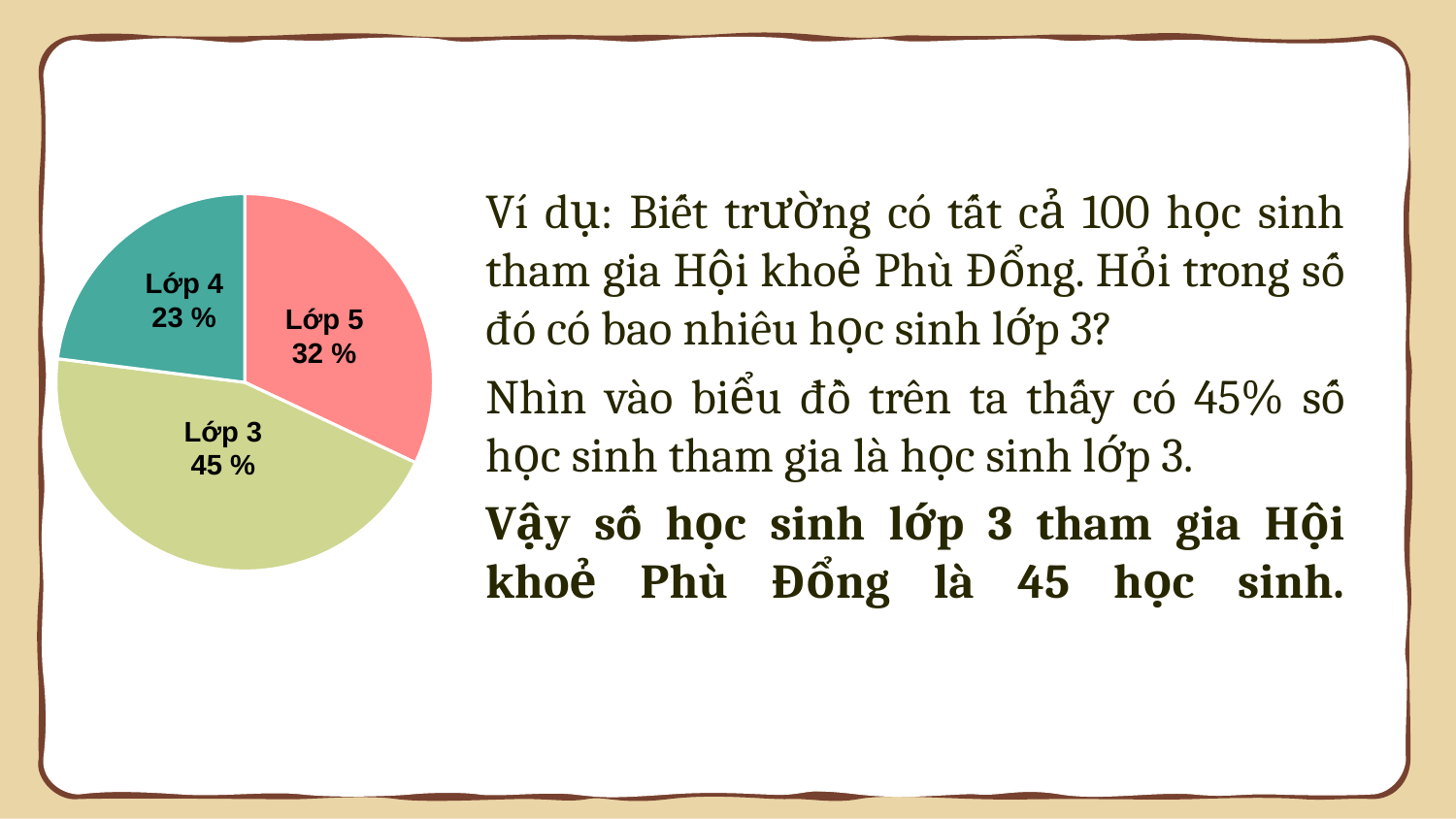
What percentage is shown for Lớp 5? 32 % What share of the pie does Lớp 3 represent? 45 % What percentage is shown for Lớp 4? 23 % What is the difference between the percentages for Lớp 3 and Lớp 5? 13 % Which class has the largest slice of the pie? Lớp 3 What percentage is shown for Lớp 3? 45 % What is the difference between the percentages for Lớp 5 and Lớp 4? 9 % How many slices does the pie chart have? 3 Which class has the smallest slice of the pie? Lớp 4 Which is larger, the slice for Lớp 4 or the slice for Lớp 5? Lớp 5 What colour is the slice for Lớp 5? pink What kind of chart is shown on the slide? pie chart